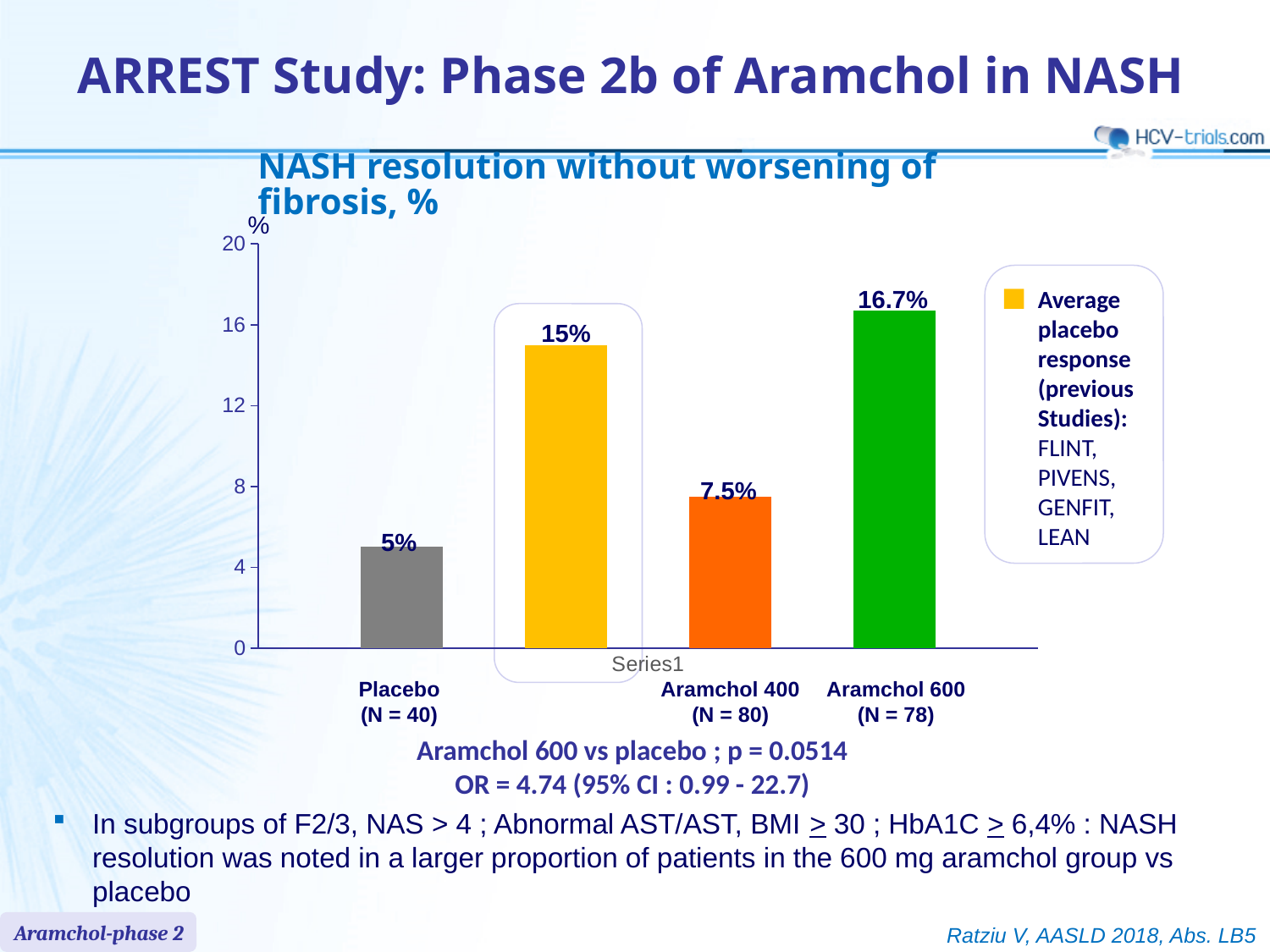
What is the title of the chart? NASH resolution without worsening of fibrosis, % What is the value for Aramchol 400 (N = 80)? 7.5% What is the difference between the Aramchol 600 value and the Placebo value? 11.7% What is the value for Placebo (N = 40)? 5% What is the value for Aramchol 600 (N = 78)? 16.7% What is the value of the yellow bar representing the average placebo response from previous studies? 15% Which bar has the highest value? Aramchol 600 (N = 78) Which is larger, the value for Aramchol 600 or the average placebo response from previous studies? Aramchol 600 What kind of chart is shown on the slide? Bar chart Which bar has the lowest value? Placebo (N = 40) What is the difference between the Aramchol 400 value and the Placebo value? 2.5% How many bars are plotted in the chart? 4